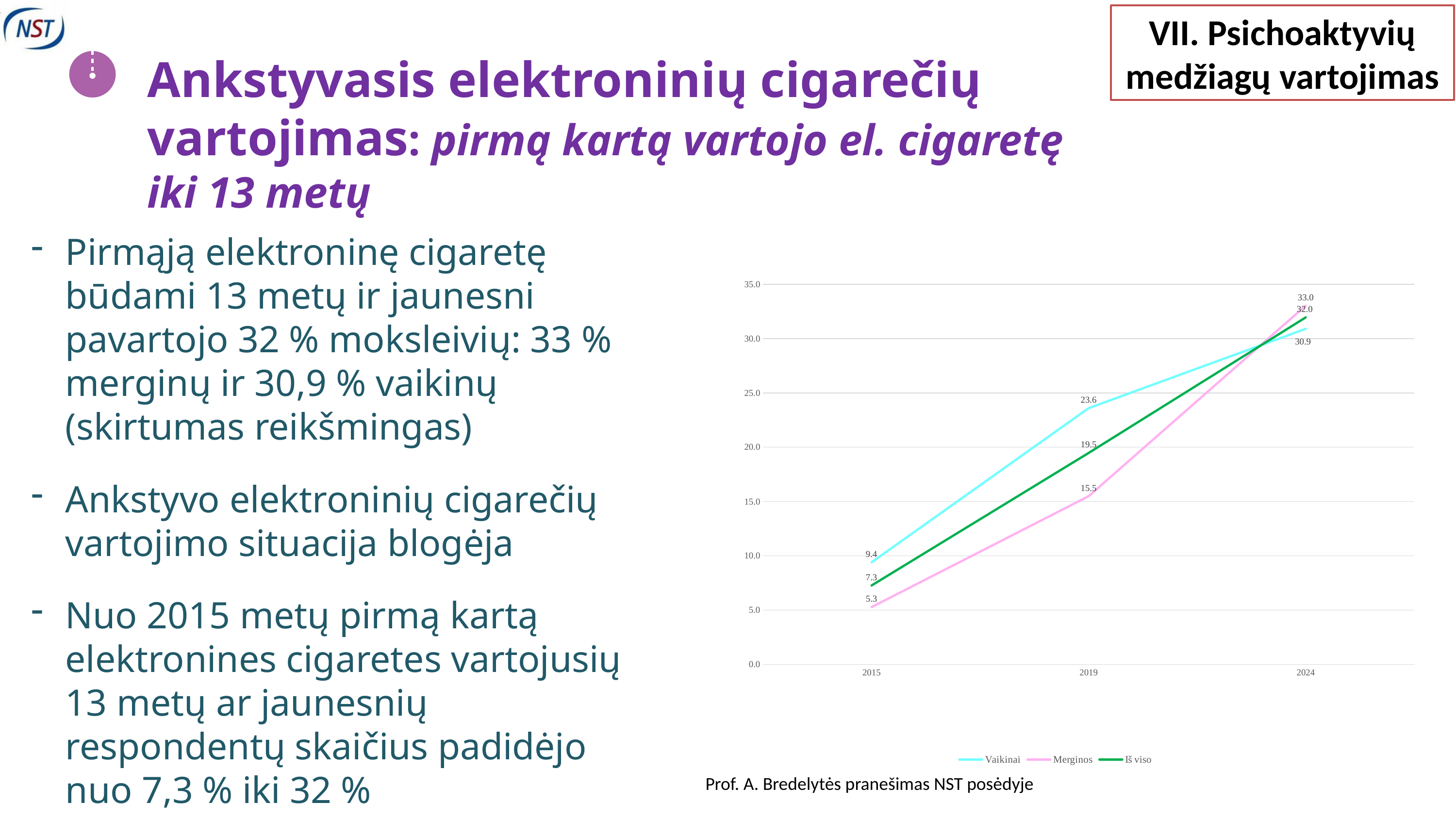
In which year is the Merginos series lowest? 2015 What is the value for Merginos in 2024? 33.0 In which year is the Iš viso series highest? 2024 What type of chart is shown on the slide? line chart How many series does the chart legend list? 3 What is the value for Merginos in 2019? 15.5 What is the value for Iš viso in 2024? 32.0 What is the difference between the Vaikinai and Merginos values in 2019? 8.1 Does the Iš viso series rise or fall from 2015 to 2024? rise Which is larger in 2015, the value for Vaikinai or the value for Merginos? Vaikinai What is the value for Vaikinai in 2015? 9.4 How many years are plotted on the x axis? 3